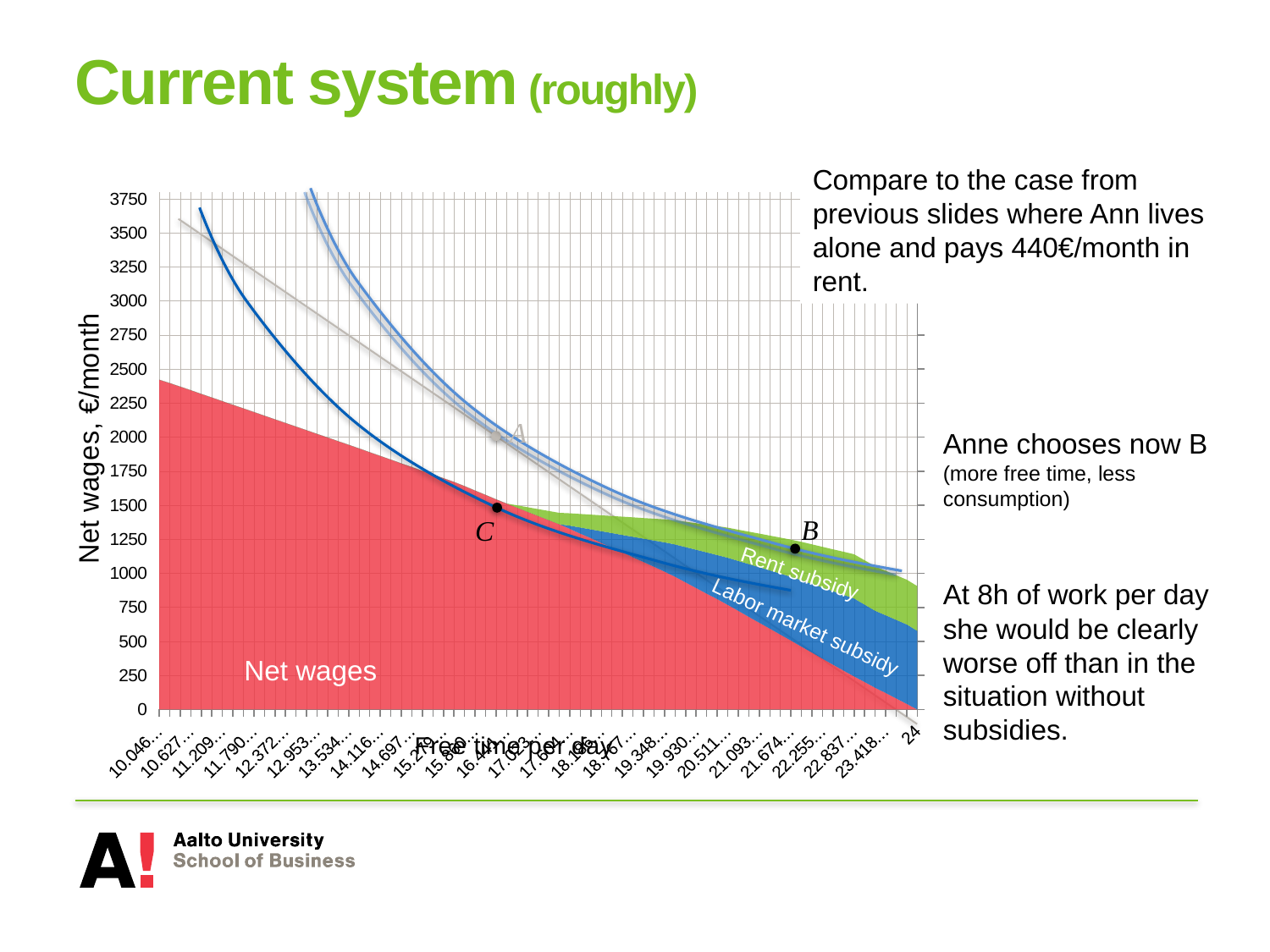
Is the net wage level at point B greater or less than 1500 €/month? less What is the label of the horizontal axis of the chart? Free time per day What is the last value shown on the horizontal axis of the chart? 24 Is the net wage at the leftmost point of the chart (free time 10.046) greater or less than 2250 €/month? greater What is the label of the vertical axis of the chart? Net wages, €/month What is the highest value shown on the vertical axis of the chart? 3750 Which shaded area is coloured red in the chart? Net wages What kind of chart is shown on the slide? Area chart How many shaded areas (series) are labelled in the chart? 3 Which of the labelled points, B or C, lies at a higher net wage level? C Does the Net wages area rise or fall as free time per day increases? Fall Which shaded area is coloured green in the chart? Rent subsidy